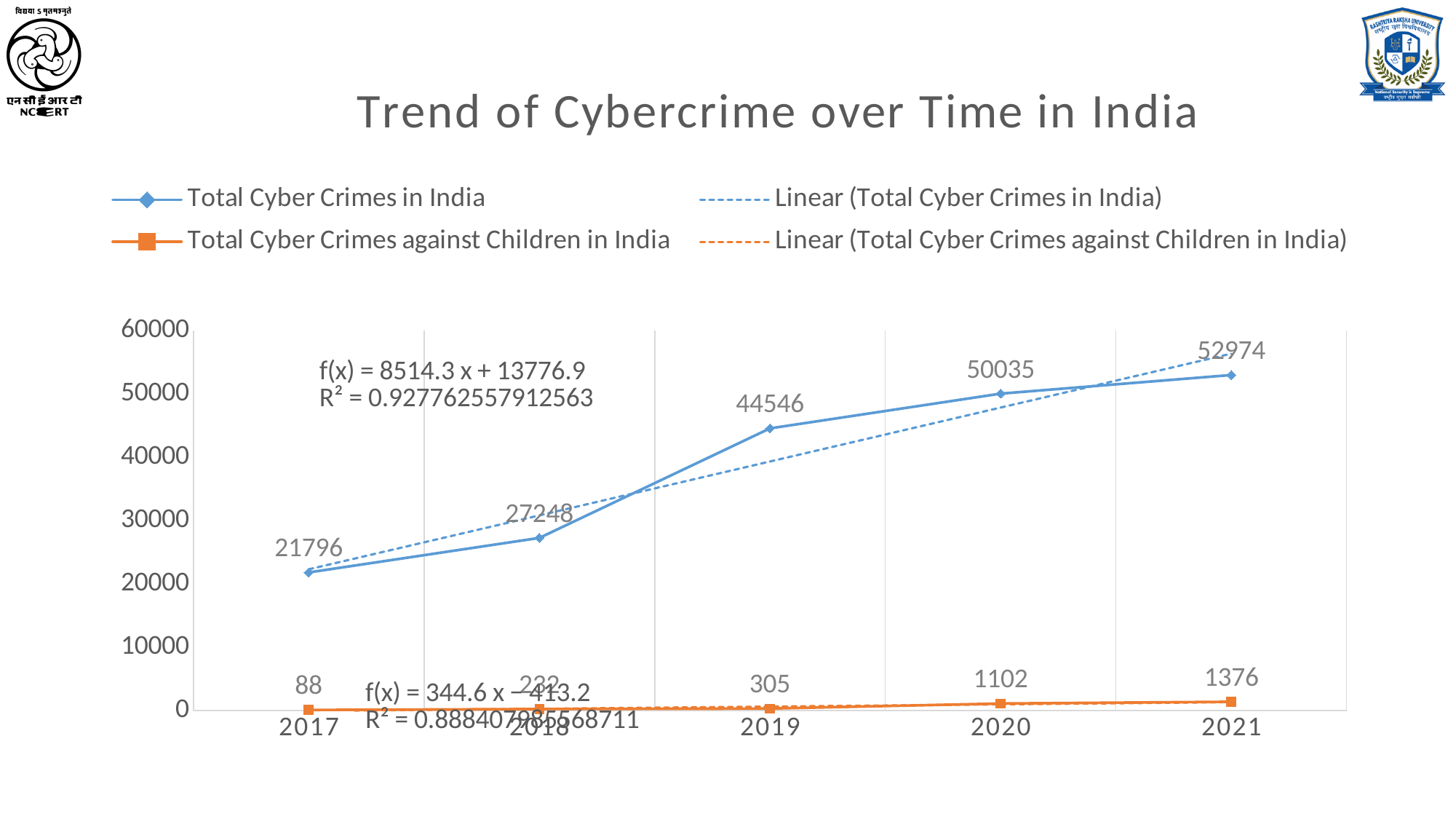
What is the difference between Total Cyber Crimes against Children in India in 2021 and in 2020? 274 How many years are plotted on the x axis? 5 Is the value for Total Cyber Crimes in India in 2018 greater or less than 30000? less What type of chart is shown on the slide? Line chart What is the difference between Total Cyber Crimes in India in 2021 and in 2017? 31178 What was the value of Total Cyber Crimes against Children in India in 2017? 88 What was the value of Total Cyber Crimes in India in 2019? 44546 In which year was Total Cyber Crimes against Children in India the highest? 2021 In which year was Total Cyber Crimes in India the lowest? 2017 What was the value of Total Cyber Crimes in India in 2021? 52974 How many entries does the legend list? 4 What was the value of Total Cyber Crimes against Children in India in 2020? 1102